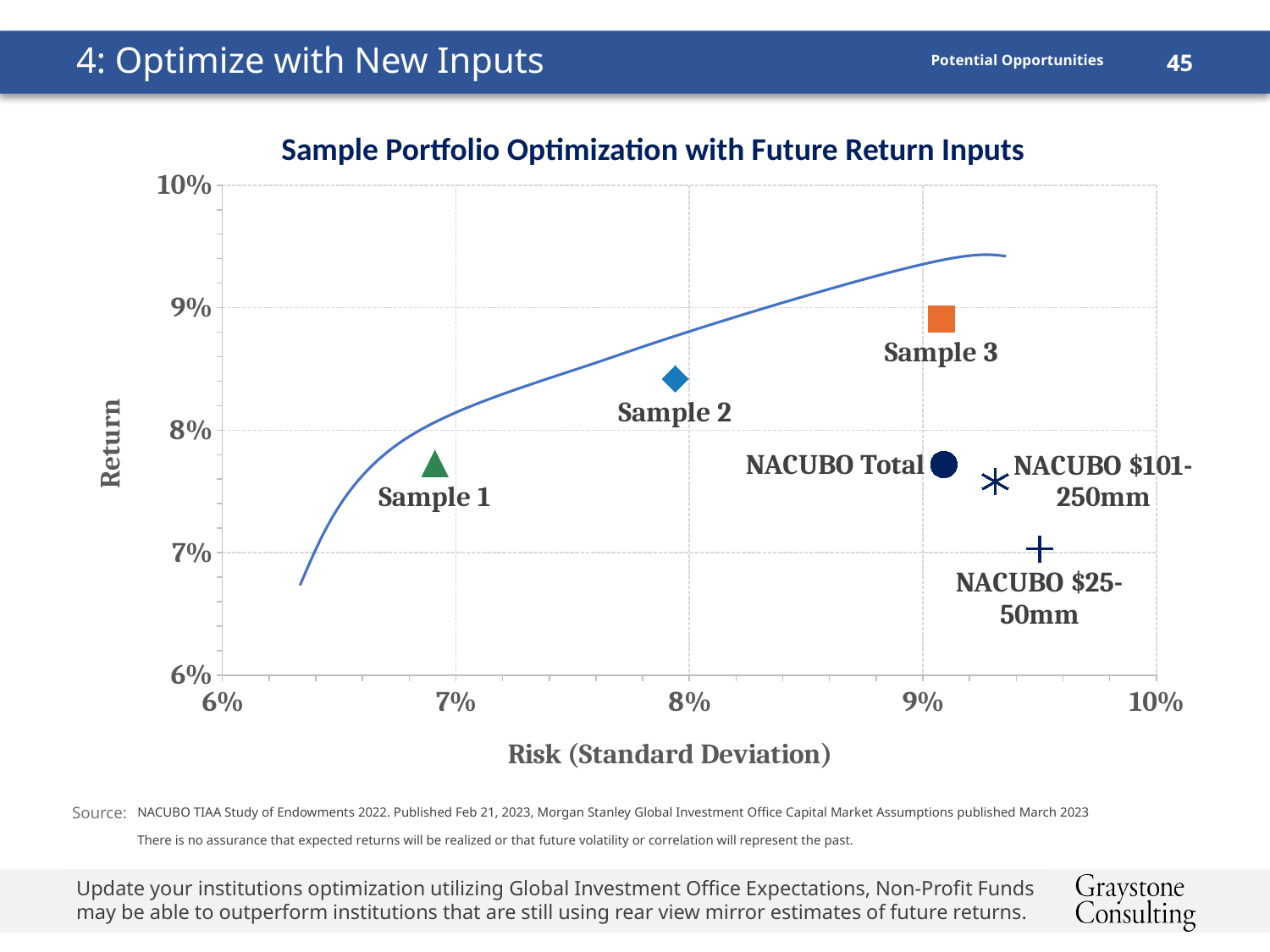
What is the label of the horizontal axis of the chart? Risk (Standard Deviation) How many labeled data points are plotted on the chart? 6 Which labeled point has the highest risk (standard deviation)? NACUBO $25-50mm Which labeled point has the highest return? Sample 3 Is the risk (standard deviation) for Sample 1 greater or less than 7%? less Which labeled point has the lowest risk (standard deviation)? Sample 1 What kind of chart is shown on the slide? Scatter chart Is the return for Sample 3 greater or less than 8%? greater Is the return for NACUBO Total greater or less than 8%? less What is the title of the chart? Sample Portfolio Optimization with Future Return Inputs Which labeled point has the lowest return? NACUBO $25-50mm Which has the higher return, Sample 1 or Sample 2? Sample 2